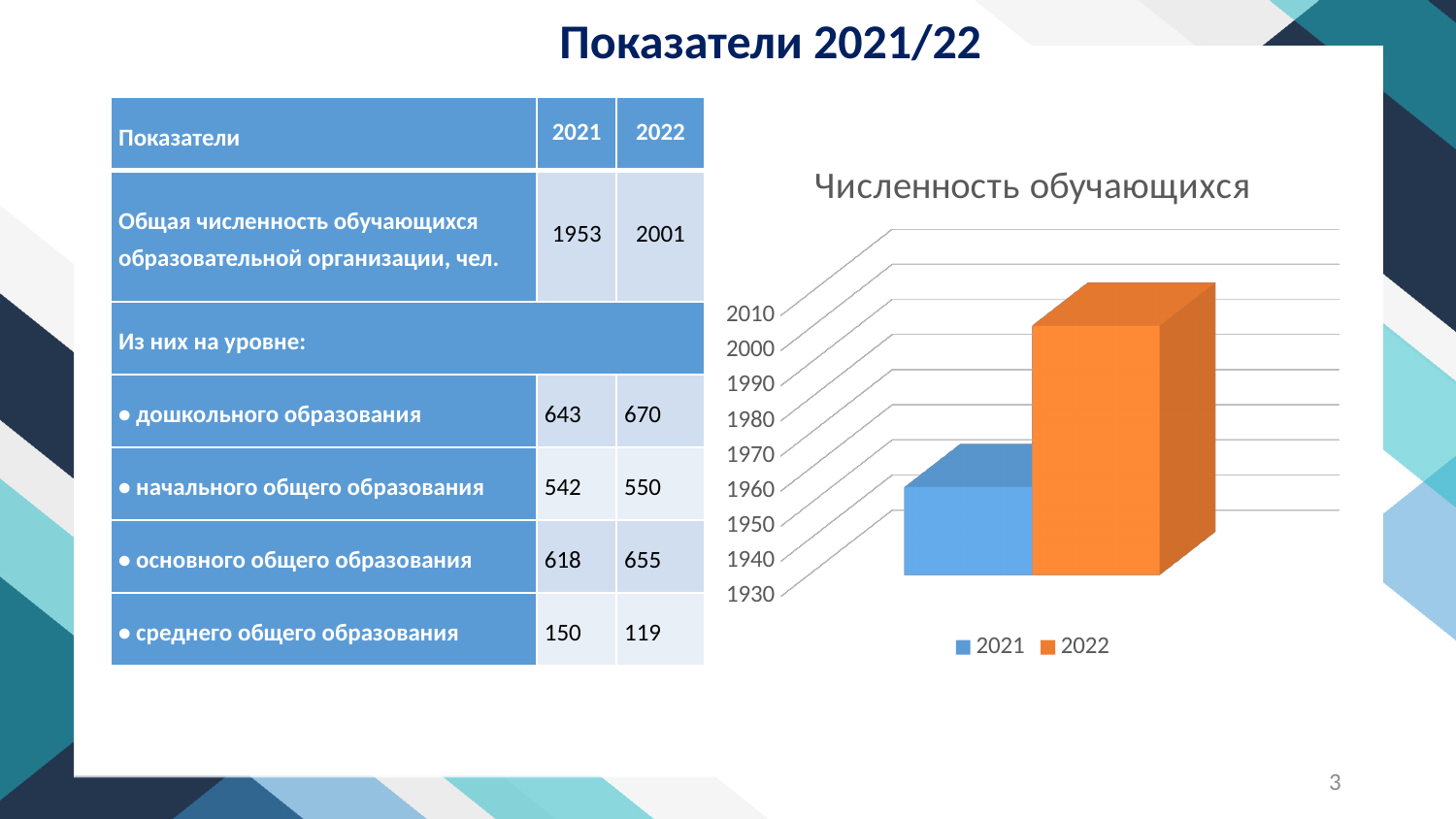
Is the value for 2022 greater or less than 1990? greater What is the title of the chart? Численность обучающихся How many bars are plotted in the chart? 2 How many series does the chart legend list? 2 Is the value for 2021 greater or less than 1940? greater Does the number of students rise or fall from 2021 to 2022 in the chart? rise Which series has the highest bar in the chart? 2022 What kind of chart is shown on the slide? bar chart Is the value for 2021 greater or less than 1970? less Which series has the lowest bar in the chart? 2021 Which series has the taller bar, 2021 or 2022? 2022 What are the entries in the chart legend? 2021, 2022